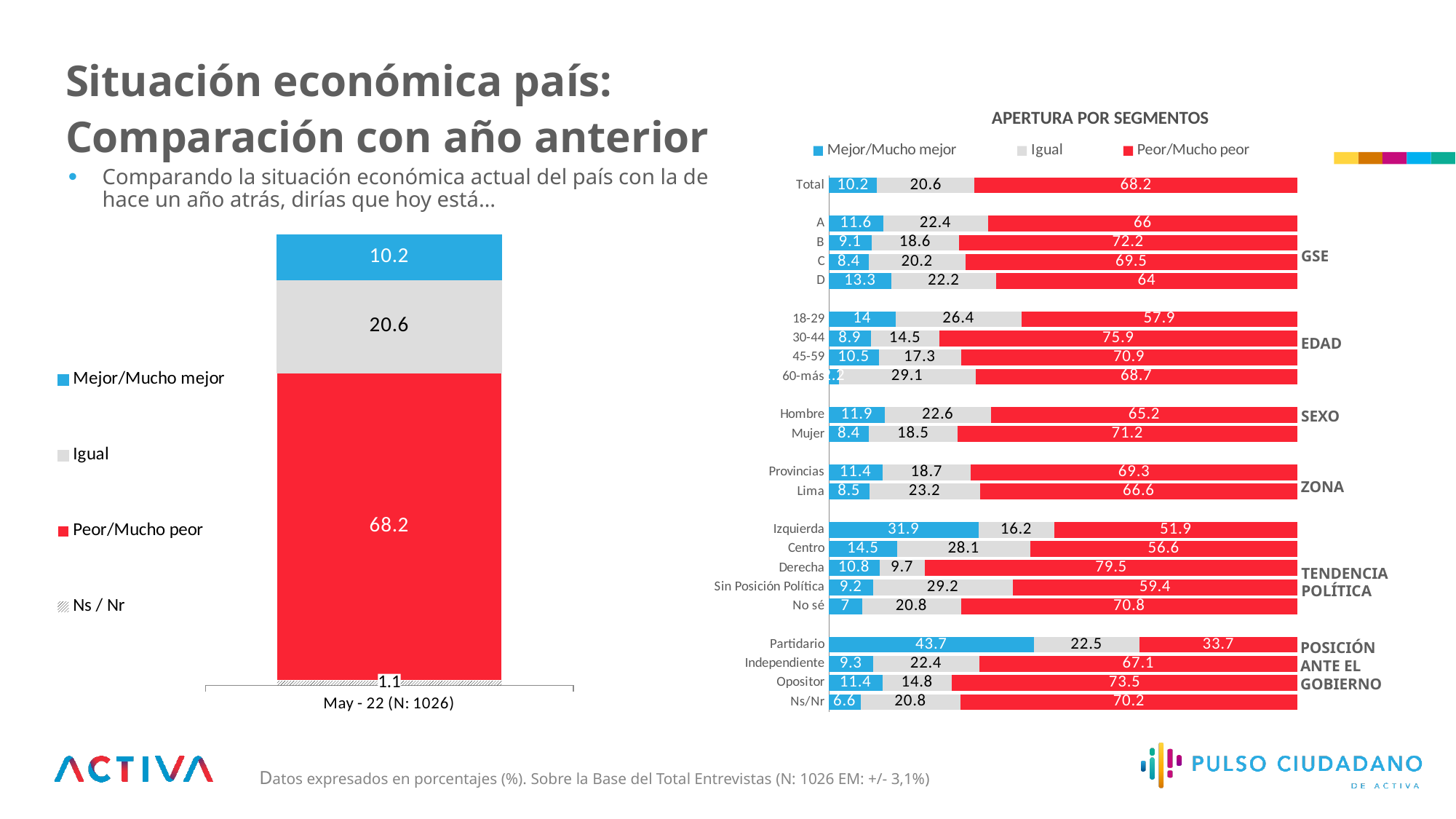
How many series does the legend of the left chart list? 4 In the left chart (May - 22), what is the value for Peor/Mucho peor? 68.2 In the left chart (May - 22), what is the value for Ns / Nr? 1.1 What kind of chart is the left chart? Stacked bar chart In the APERTURA POR SEGMENTOS chart, what is the Mejor/Mucho mejor value for Partidario? 43.7 How many categories (rows) are plotted in the APERTURA POR SEGMENTOS chart? 22 In the APERTURA POR SEGMENTOS chart, which has a larger Igual value, Centro or Derecha? Centro In the APERTURA POR SEGMENTOS chart, which category has the highest Peor/Mucho peor value? Derecha How many series does the legend of the APERTURA POR SEGMENTOS chart list? 3 In the APERTURA POR SEGMENTOS chart, what is the Peor/Mucho peor value for Derecha? 79.5 In the APERTURA POR SEGMENTOS chart, what is the difference between the Peor/Mucho peor values for Derecha and Izquierda? 27.6 In the APERTURA POR SEGMENTOS chart, which category has the lowest Peor/Mucho peor value? Partidario